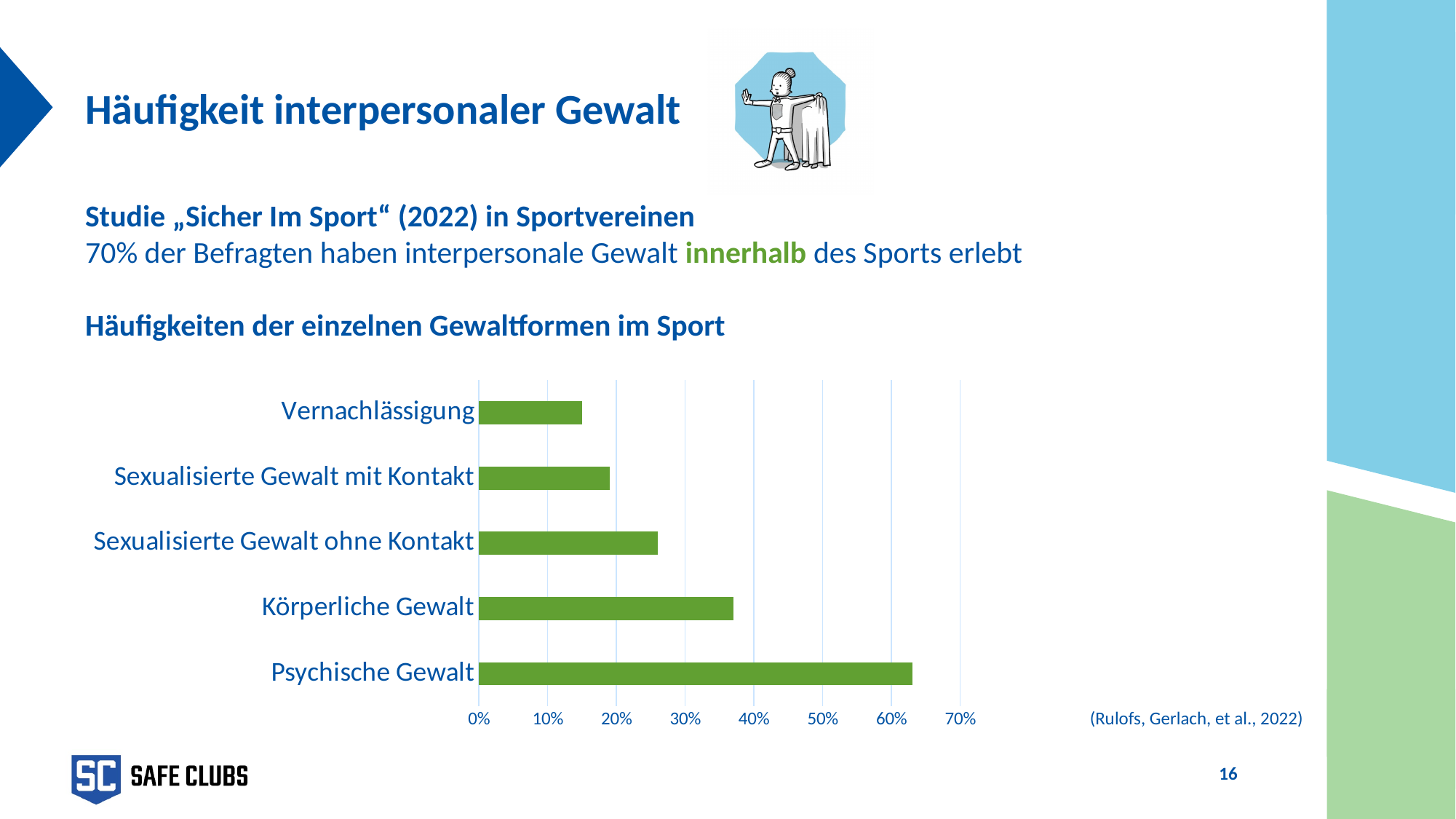
Is the value for Sexualisierte Gewalt mit Kontakt greater or less than 10%? greater Is the value for Vernachlässigung greater or less than 20%? less Which is larger, the value for Psychische Gewalt or the value for Körperliche Gewalt? Psychische Gewalt Which category has the highest value in the chart? Psychische Gewalt Is the value for Sexualisierte Gewalt ohne Kontakt greater or less than 20%? greater Which is larger, the value for Körperliche Gewalt or the value for Sexualisierte Gewalt ohne Kontakt? Körperliche Gewalt Which category has the lowest value in the chart? Vernachlässigung How many categories (forms of violence) are shown in the chart? 5 What is the highest tick label shown on the horizontal axis of the chart? 70% What kind of chart is shown on the slide? bar chart